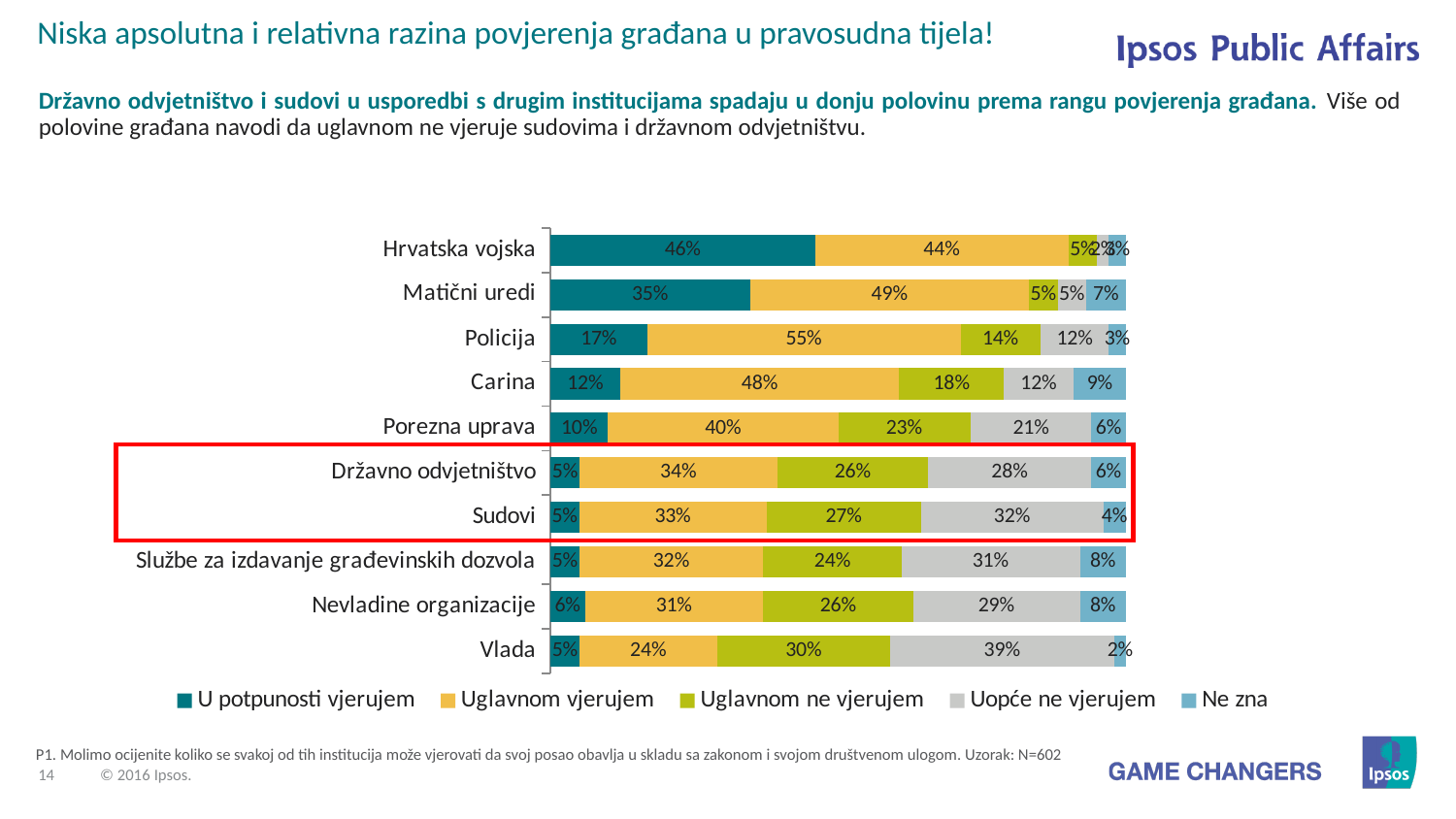
What is the "Ne zna" value for Carina? 9% How many institutions are shown in the chart? 10 What is the difference between the "Uglavnom vjerujem" values for Policija and Carina? 7% Which institution has the lowest "Uglavnom vjerujem" value? Vlada How many series does the legend list? 5 What percentage of respondents answered "U potpunosti vjerujem" for Hrvatska vojska? 46% Which institution has the highest "Uopće ne vjerujem" value? Vlada What is the "Uglavnom vjerujem" value for Policija? 55% What is the "Uopće ne vjerujem" value for Sudovi? 32% Which is larger: the "Uopće ne vjerujem" value for Državno odvjetništvo or for Sudovi? Sudovi Which institution has the highest "U potpunosti vjerujem" value? Hrvatska vojska What is the "Uglavnom ne vjerujem" value for Vlada? 30%